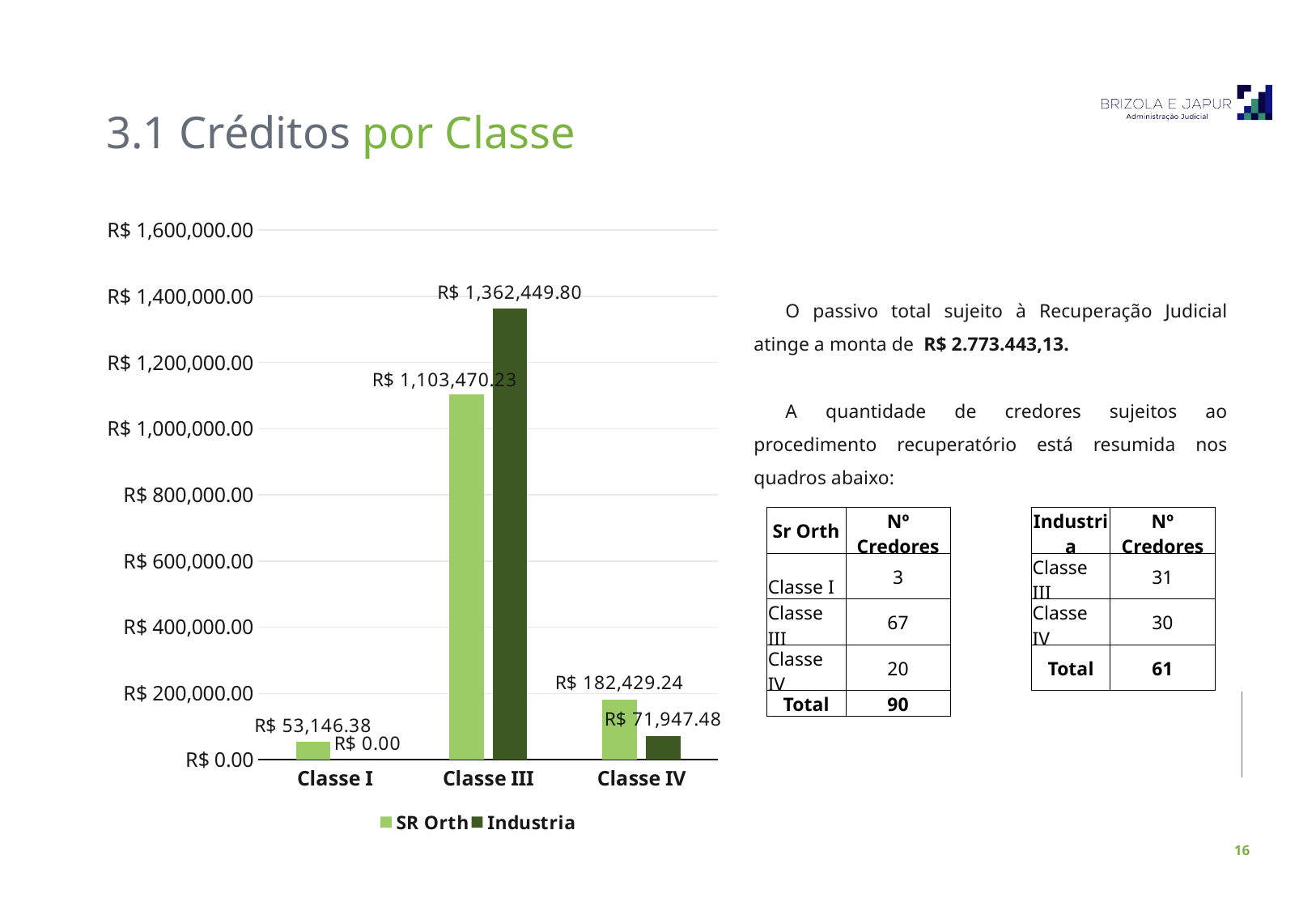
How many series does the chart legend list? 2 What is the difference between the SR Orth and Industria values in Classe IV? R$ 110,481.76 What is the value for SR Orth in Classe III? R$ 1,103,470.23 How many categories are shown on the x axis of the chart? 3 What is the value for SR Orth in Classe I? R$ 53,146.38 What is the value for Industria in Classe III? R$ 1,362,449.80 What kind of chart is shown on the slide? Bar chart In Classe IV, which series has the larger value, SR Orth or Industria? SR Orth Which category has the lowest value for SR Orth? Classe I What is the value for Industria in Classe IV? R$ 71,947.48 Which category has the highest value for Industria? Classe III What is the difference between the Industria and SR Orth values in Classe III? R$ 258,979.57